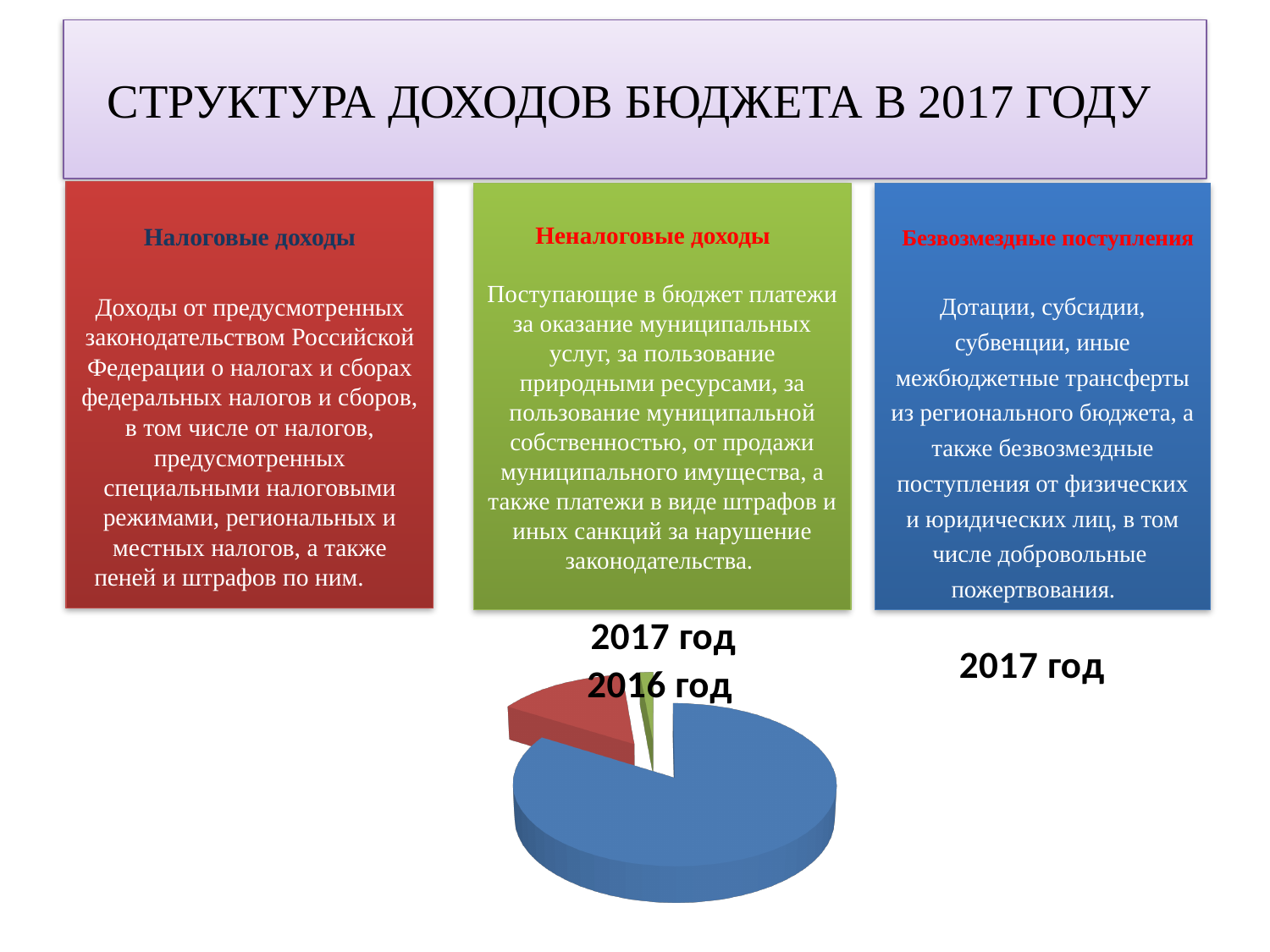
In the pie chart, which slice is larger, the blue one or the red one? blue Is the blue slice of the pie chart more or less than half of the whole pie? more Which colour slice is the smallest in the pie chart? green What kind of chart is shown at the bottom of the slide? pie chart Which colour slice is the largest in the pie chart? blue Does the pie chart display a legend? No Is the pie chart drawn in 3D or flat 2D? 3D In the pie chart, which slice is larger, the red one or the green one? red How many slices does the pie chart have? 3